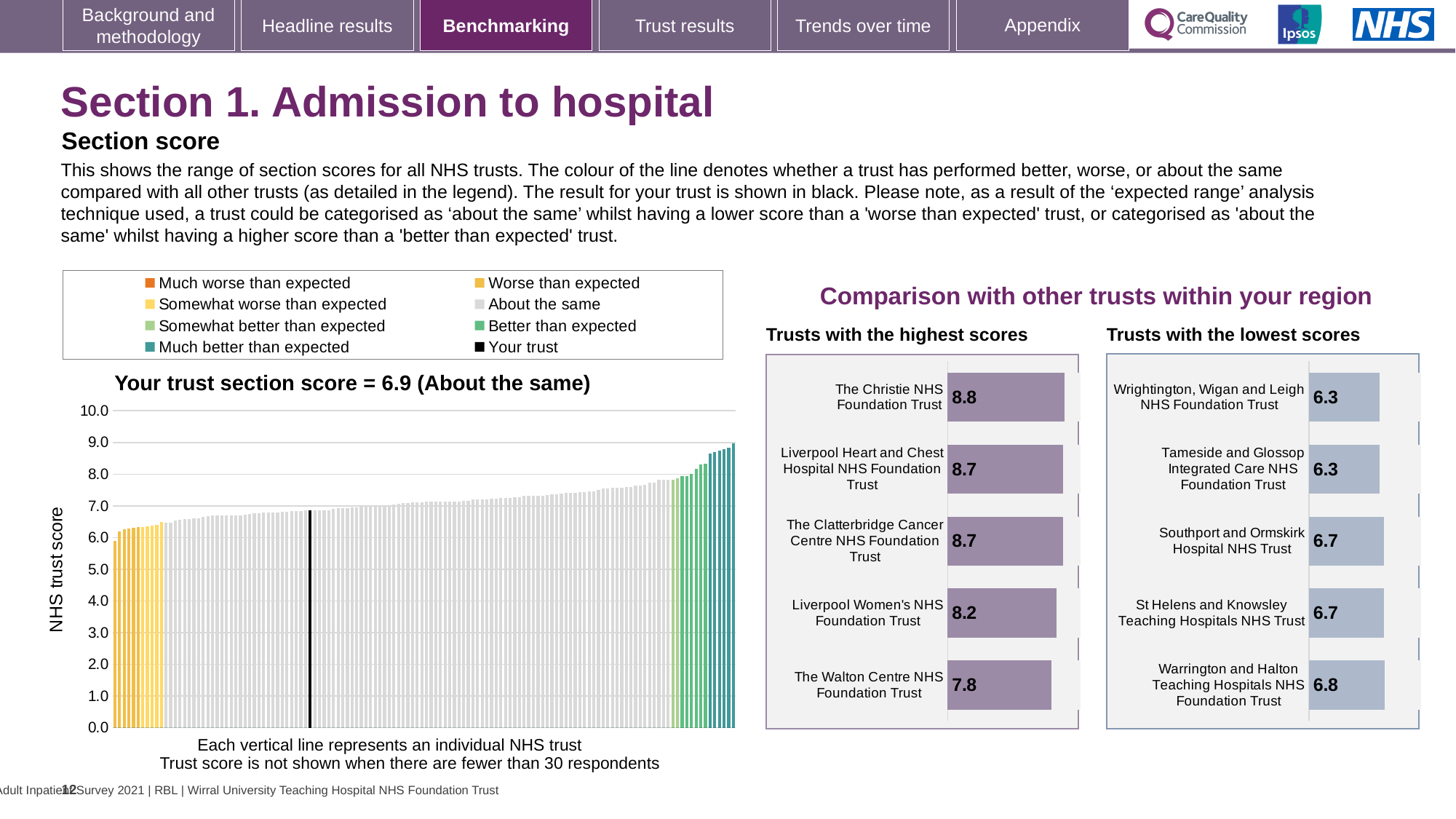
On the 'Your trust section score' chart, is the value of the leftmost (lowest) bar greater or less than 7.0? less On the 'Trusts with the highest scores' chart, what is the difference between the scores of The Christie NHS Foundation Trust and The Walton Centre NHS Foundation Trust? 1.0 How many entries does the legend above the 'Your trust section score' chart list? 8 On the 'Your trust section score' chart, is the value of the rightmost (highest) bar greater or less than 8.0? greater On the 'Trusts with the lowest scores' chart, how many trusts are shown? 5 On the 'Trusts with the lowest scores' chart, which has the larger score: Southport and Ormskirk Hospital NHS Trust or Wrightington, Wigan and Leigh NHS Foundation Trust? Southport and Ormskirk Hospital NHS Trust On the 'Your trust section score' chart, what is the section score for your trust? 6.9 On the 'Trusts with the lowest scores' chart, which trust has the highest score? Warrington and Halton Teaching Hospitals NHS Foundation Trust What kind of chart is the 'Your trust section score' chart? bar chart On the 'Your trust section score' chart, do the trust scores rise or fall from left to right along the x axis? rise On the 'Trusts with the highest scores' chart, which trust has the highest score? The Christie NHS Foundation Trust On the 'Trusts with the highest scores' chart, what is the score for The Walton Centre NHS Foundation Trust? 7.8